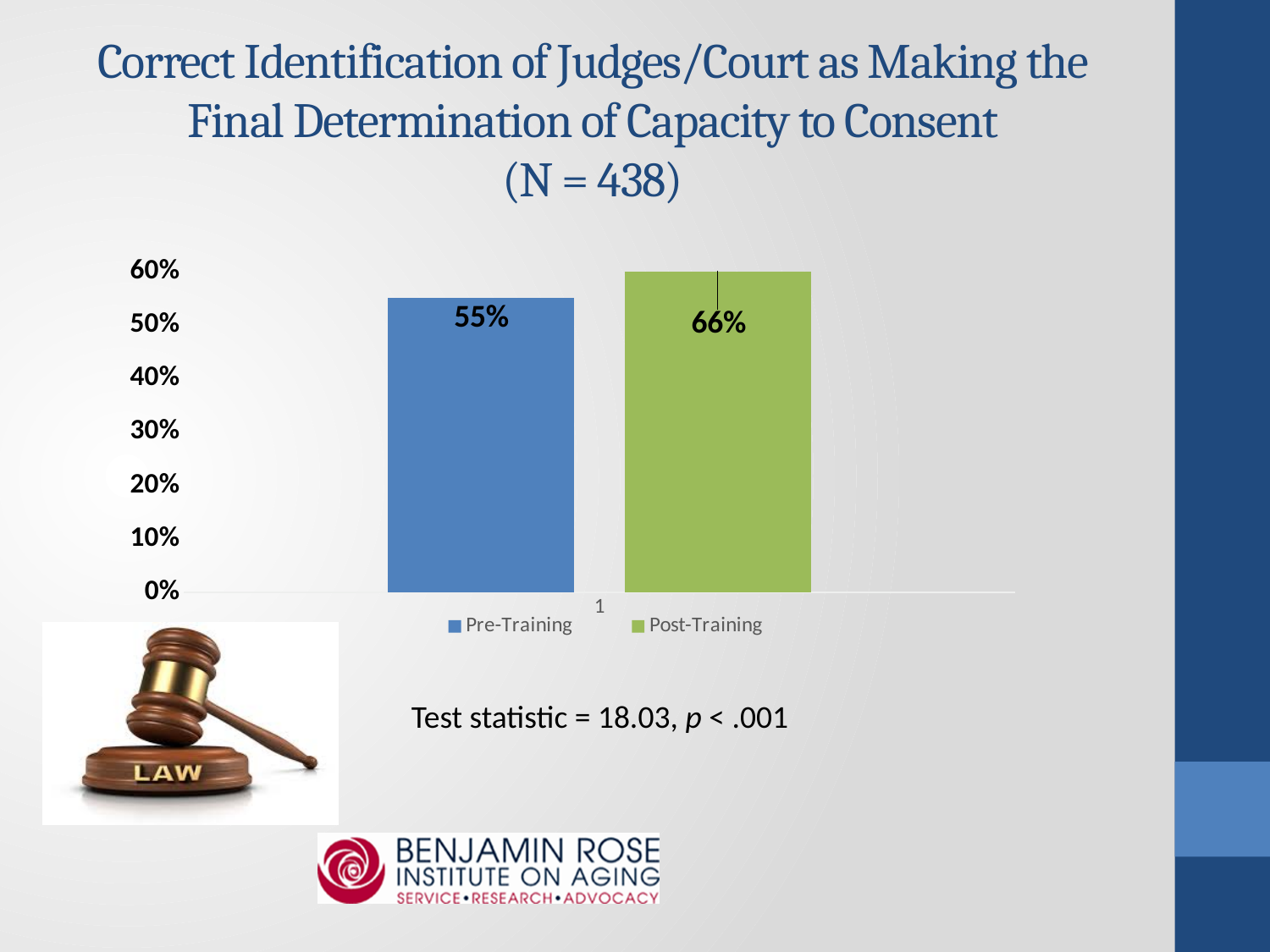
How many bars are plotted in the chart? 2 Which series has the highest value? Post-Training What kind of chart is shown on the slide? Bar chart How many series does the legend list? 2 What is the value for Pre-Training? 55% What colour is the Post-Training bar? Green What is the value for Post-Training? 66% What is the difference between the Post-Training and Pre-Training values? 11% Which series has the lowest value? Pre-Training Which series has the higher value, Pre-Training or Post-Training? Post-Training Is the value for Pre-Training greater or less than 60%? less Is the value for Pre-Training greater or less than 50%? greater